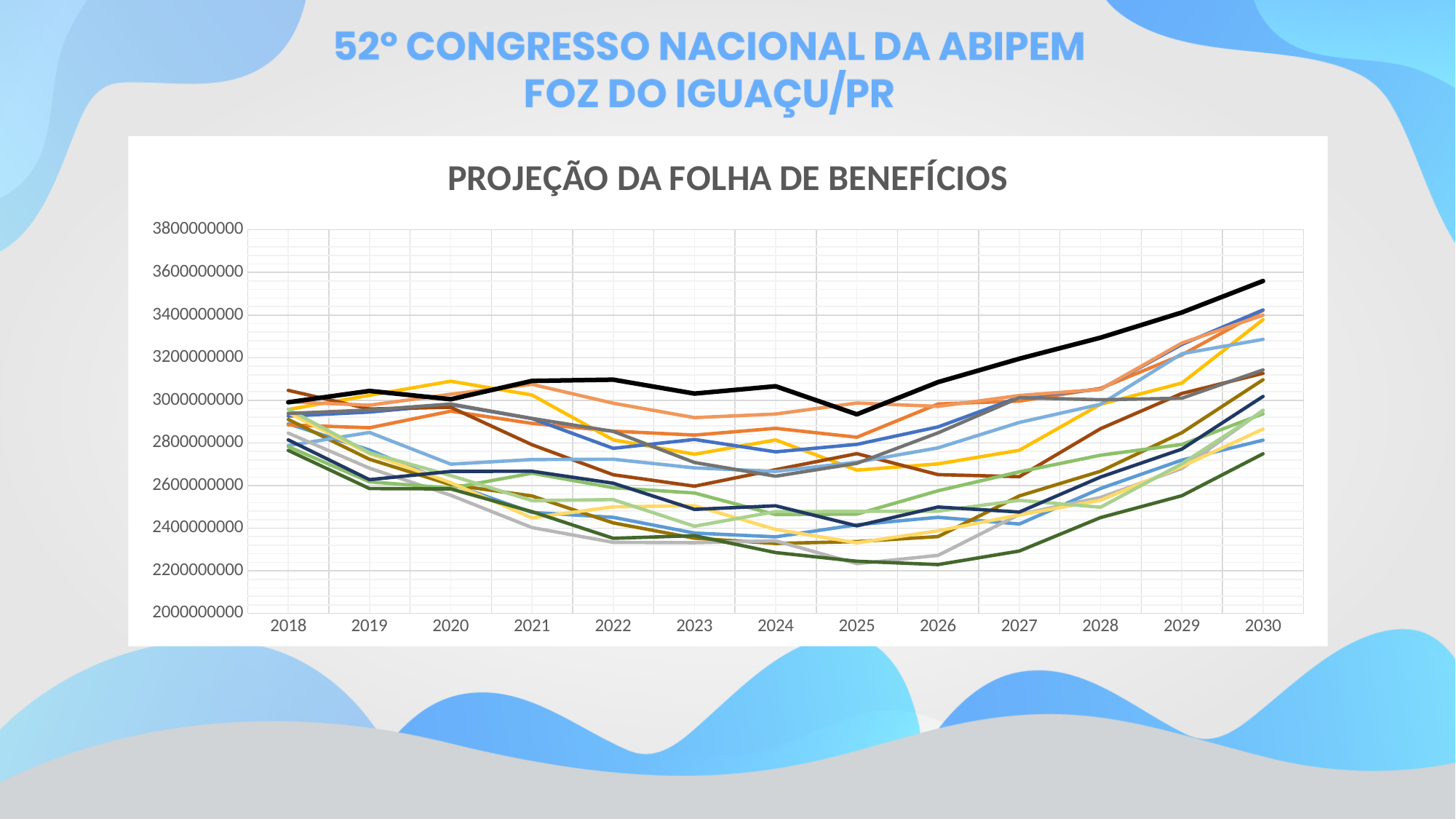
What is the title of the chart? PROJEÇÃO DA FOLHA DE BENEFÍCIOS Is the value of the thick black line in 2030 greater or less than 3400000000? greater Is the lowest line on the chart in 2030 greater or less than 2800000000? less Does the thick black line rise or fall between 2025 and 2030? rise Is the value of the thick black line in 2025 greater or less than 3000000000? less How many years are shown along the x axis of the chart? 13 In which year does the thick black line reach its lowest value? 2025 What kind of chart is shown on the slide? line chart Is the value of the thick black line in 2030 larger or smaller than its value in 2018? larger In which year does the thick black line reach its highest value? 2030 What is the first year shown on the x axis? 2018